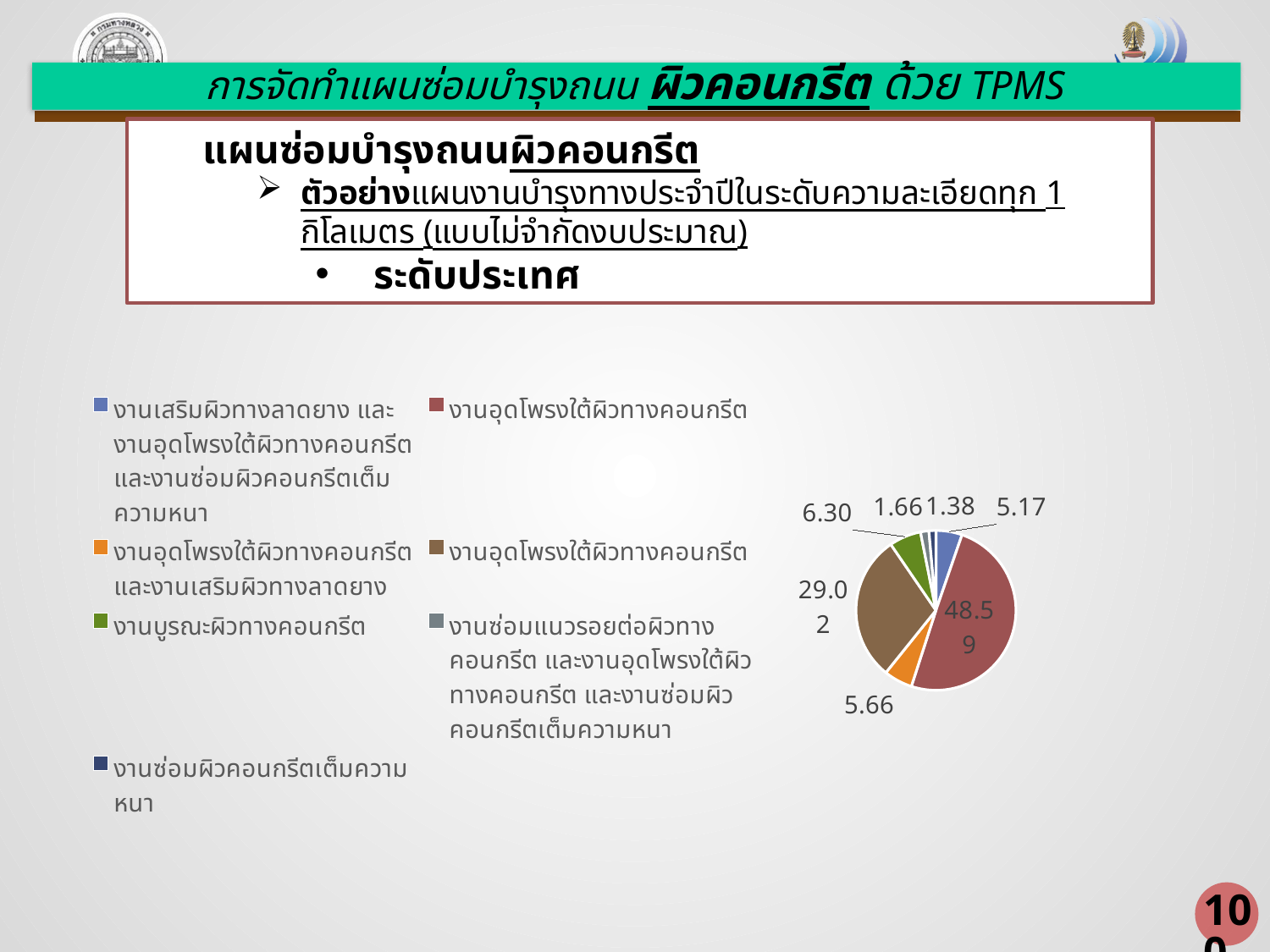
What colour is the largest slice (48.59) in the pie chart? red How many entries does the legend of the pie chart list? 7 What is the difference between the two largest slice values in the pie chart (48.59 and 29.02)? 19.57 What is the value of the largest slice in the pie chart? 48.59 Which has the larger value in the pie chart: งานบูรณะผิวทางคอนกรีต or งานอุดโพรงใต้ผิวทางคอนกรีต และงานเสริมผิวทางลาดยาง? งานบูรณะผิวทางคอนกรีต What is the value shown for งานซ่อมแนวรอยต่อผิวทางคอนกรีต และงานอุดโพรงใต้ผิวทางคอนกรีต และงานซ่อมผิวคอนกรีตเต็มความหนา in the pie chart? 1.66 What is the value shown for งานซ่อมผิวคอนกรีตเต็มความหนา in the pie chart? 1.38 What kind of chart is shown on the slide? pie chart What is the value shown for งานบูรณะผิวทางคอนกรีต in the pie chart? 6.30 How many slices does the pie chart have? 7 What is the value of the smallest slice in the pie chart? 1.38 What is the value shown for งานอุดโพรงใต้ผิวทางคอนกรีต และงานเสริมผิวทางลาดยาง in the pie chart? 5.66